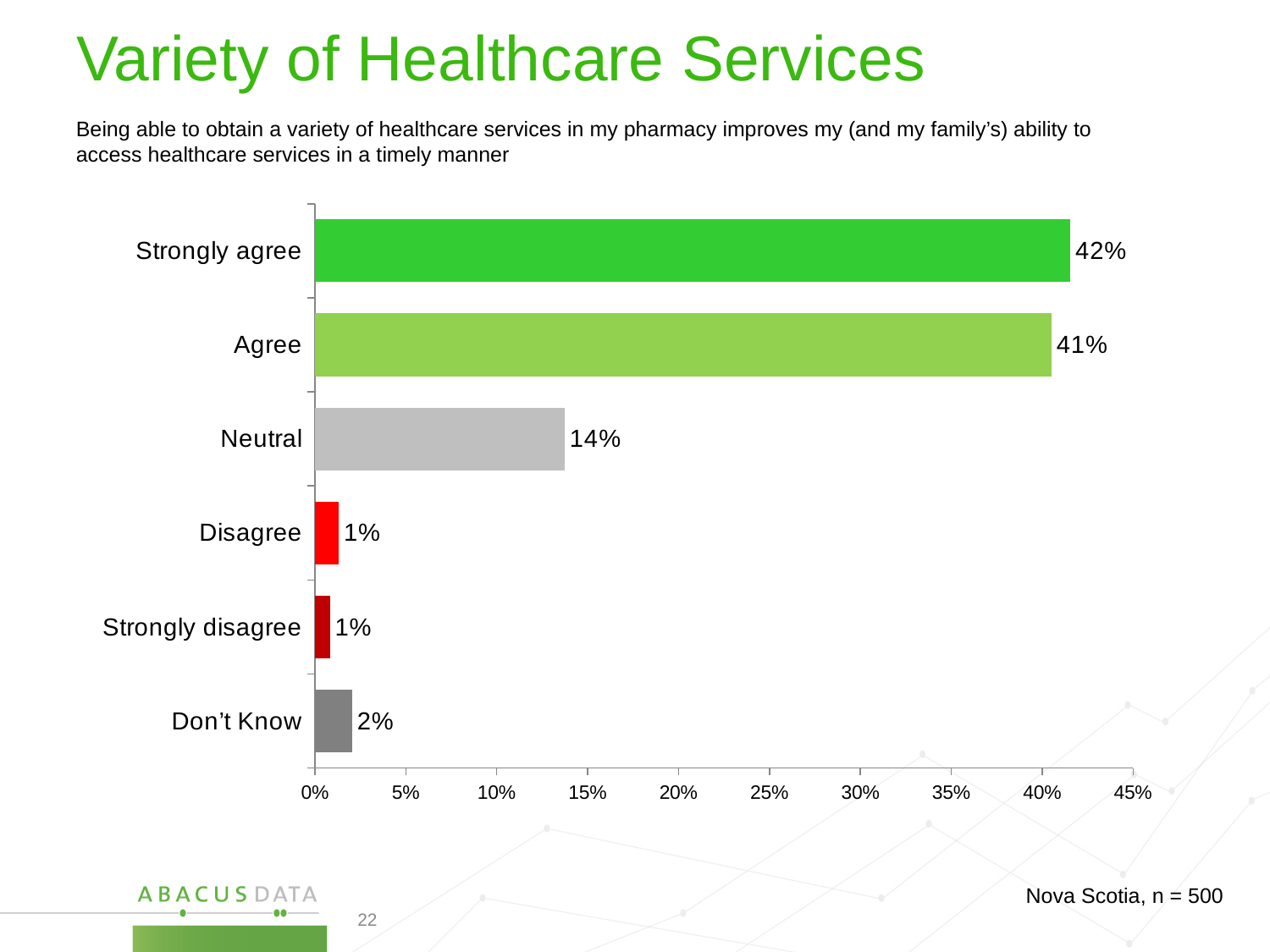
What is the sample size noted on the slide? n = 500 What is the combined value of "Strongly agree" and "Agree"? 83% Which response category has the highest value? Strongly agree What is the difference between the "Strongly agree" and "Agree" values? 1% What type of chart is shown on the slide? Bar chart What is the value shown for "Neutral"? 14% What is the difference between the "Agree" and "Neutral" values? 27% Which is larger, the value for "Neutral" or the value for "Don't Know"? Neutral What percentage of respondents answered "Don't Know"? 2% What percentage of respondents selected "Strongly agree"? 42% How many response categories are shown in the chart? 6 What is the value for "Agree"? 41%